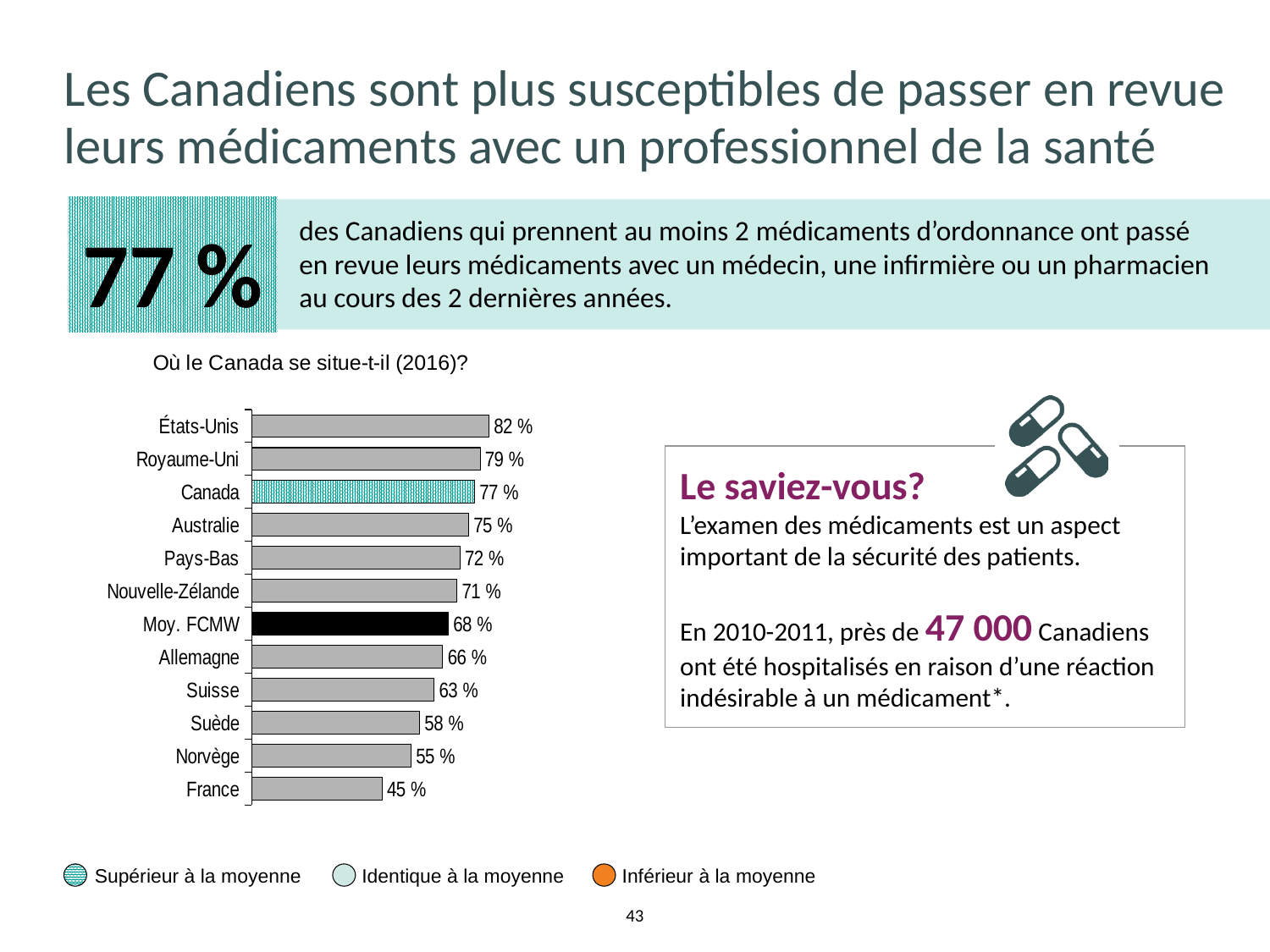
How many bars are shown in the chart? 12 What is the value for Moy. FCMW in the chart? 68 % What is the value for Nouvelle-Zélande in the chart? 71 % Which country has the lowest value in the chart? France What is the difference between the values for Canada and Moy. FCMW? 9 % What kind of chart is shown on the slide? Bar chart Which has a larger value, Suède or Suisse? Suisse What is the value for Canada in the chart? 77 % What is the difference between the values for États-Unis and France? 37 % Which country has the highest value in the chart? États-Unis What is the title of the chart? Où le Canada se situe-t-il (2016)? Which has a larger value, Australie or Pays-Bas? Australie